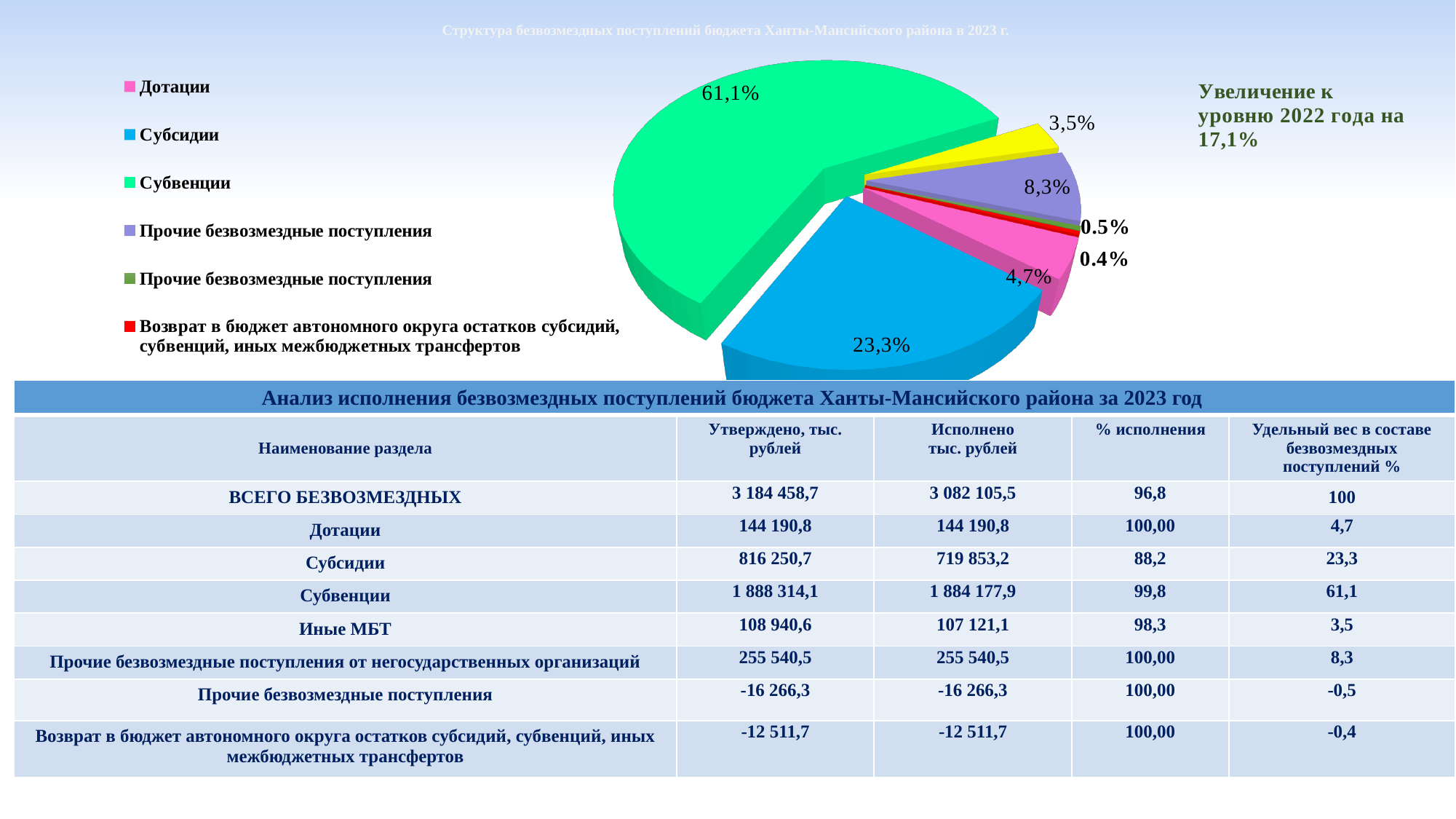
Which category has the largest slice of the pie? Субвенции How many entries does the legend of the pie chart list? 6 What share of the pie does Субвенции hold? 61,1% What share of the pie does Дотации hold? 4,7% What is the difference in percentage points between the Субвенции slice and the Субсидии slice? 37,8 What colour is the Субвенции slice in the pie chart? green Which slice is larger, Субсидии or Дотации? Субсидии What kind of chart is shown on the slide? pie chart What colour is the Субсидии slice in the pie chart? blue Which category has the smallest slice of the pie? Возврат в бюджет автономного округа остатков субсидий, субвенций, иных межбюджетных трансфертов What share of the pie does Субсидии hold? 23,3% How many slices does the pie chart have? 7